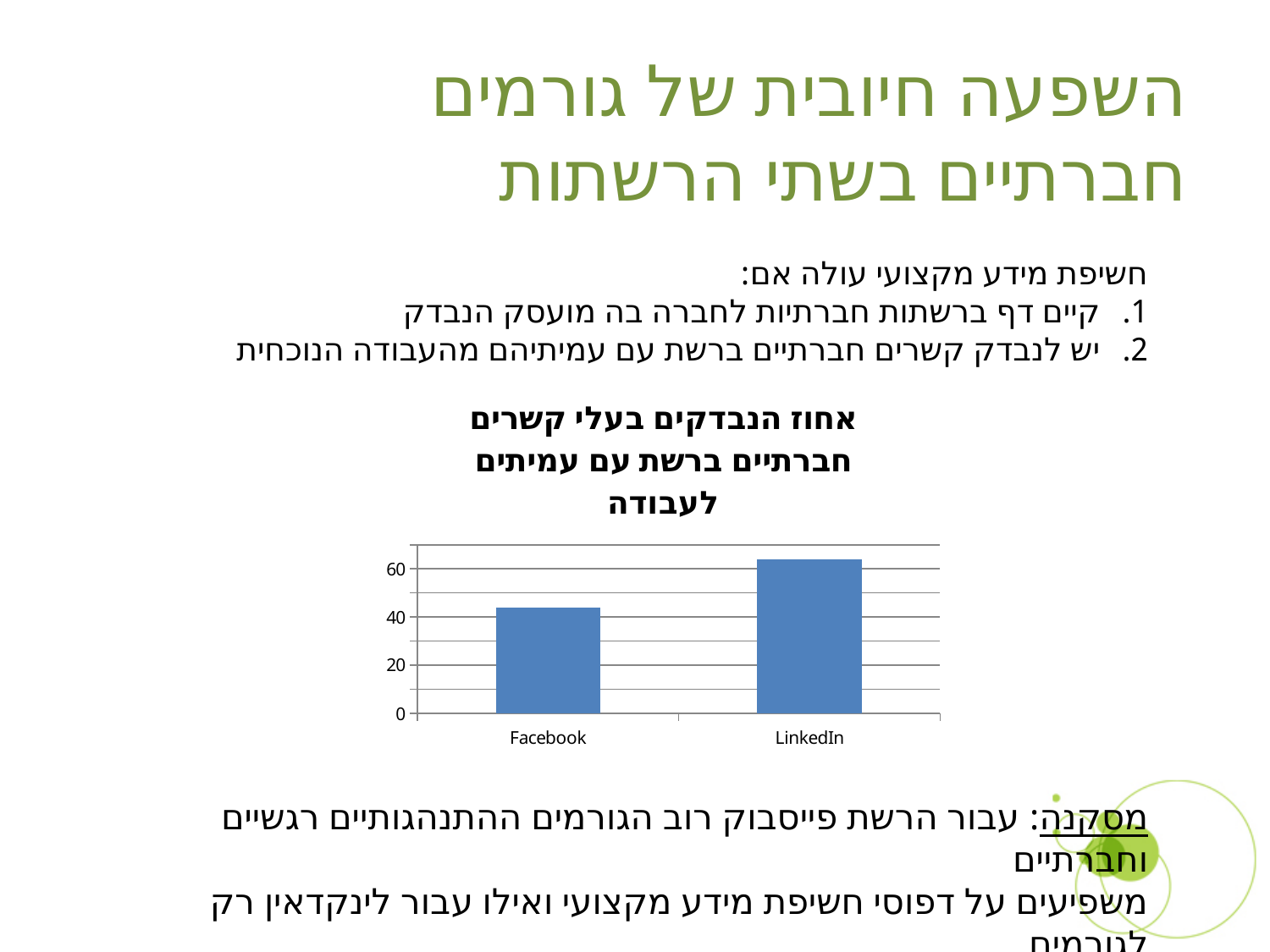
Is the value for Facebook greater or less than 60? less Which is larger, the value for Facebook or the value for LinkedIn? LinkedIn Which category has the lowest bar in the chart? Facebook What kind of chart is shown on the slide? bar chart What colour are the bars in the chart? blue Is the value for Facebook greater or less than 40? greater How many categories are plotted in the chart? 2 Which category has the highest bar in the chart? LinkedIn Is the value for LinkedIn greater or less than 40? greater What is the title of the chart? אחוז הנבדקים בעלי קשרים חברתיים ברשת עם עמיתים לעבודה Do the values rise or fall going from Facebook to LinkedIn along the x axis? rise